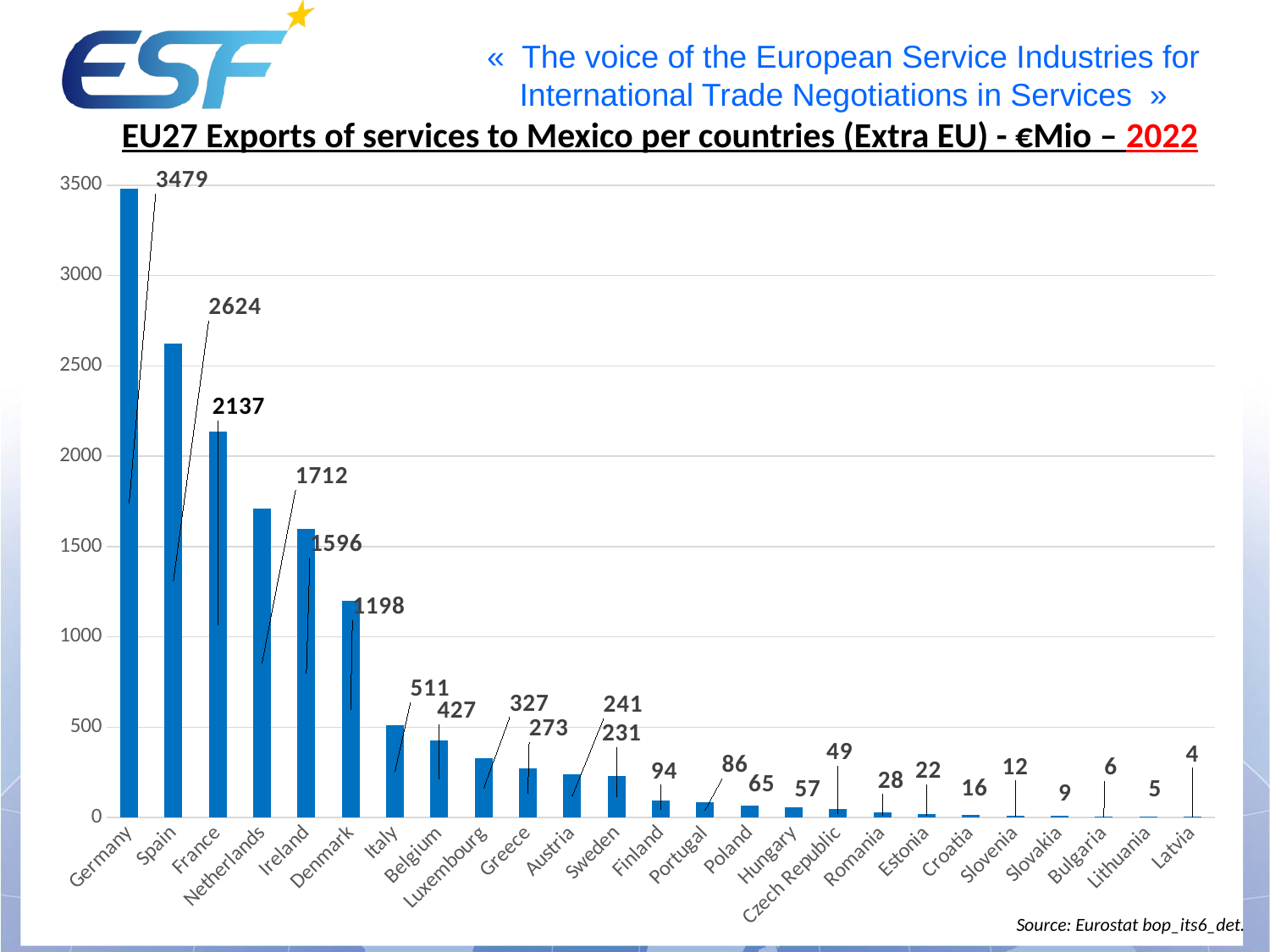
Do the values rise or fall from left to right along the x axis? Fall What is the value for Czech Republic? 49 What is the value for Luxembourg? 327 What is the value for Netherlands? 1712 Which country has the highest value? Germany Which is larger, the value for Italy or the value for Belgium? Italy What is the difference between the values for Spain and France? 487 Which country has the lowest value? Latvia How many countries are shown on the chart? 25 What is the value for Germany? 3479 What kind of chart is this? Bar chart Is the value for Denmark greater or less than 1000? greater